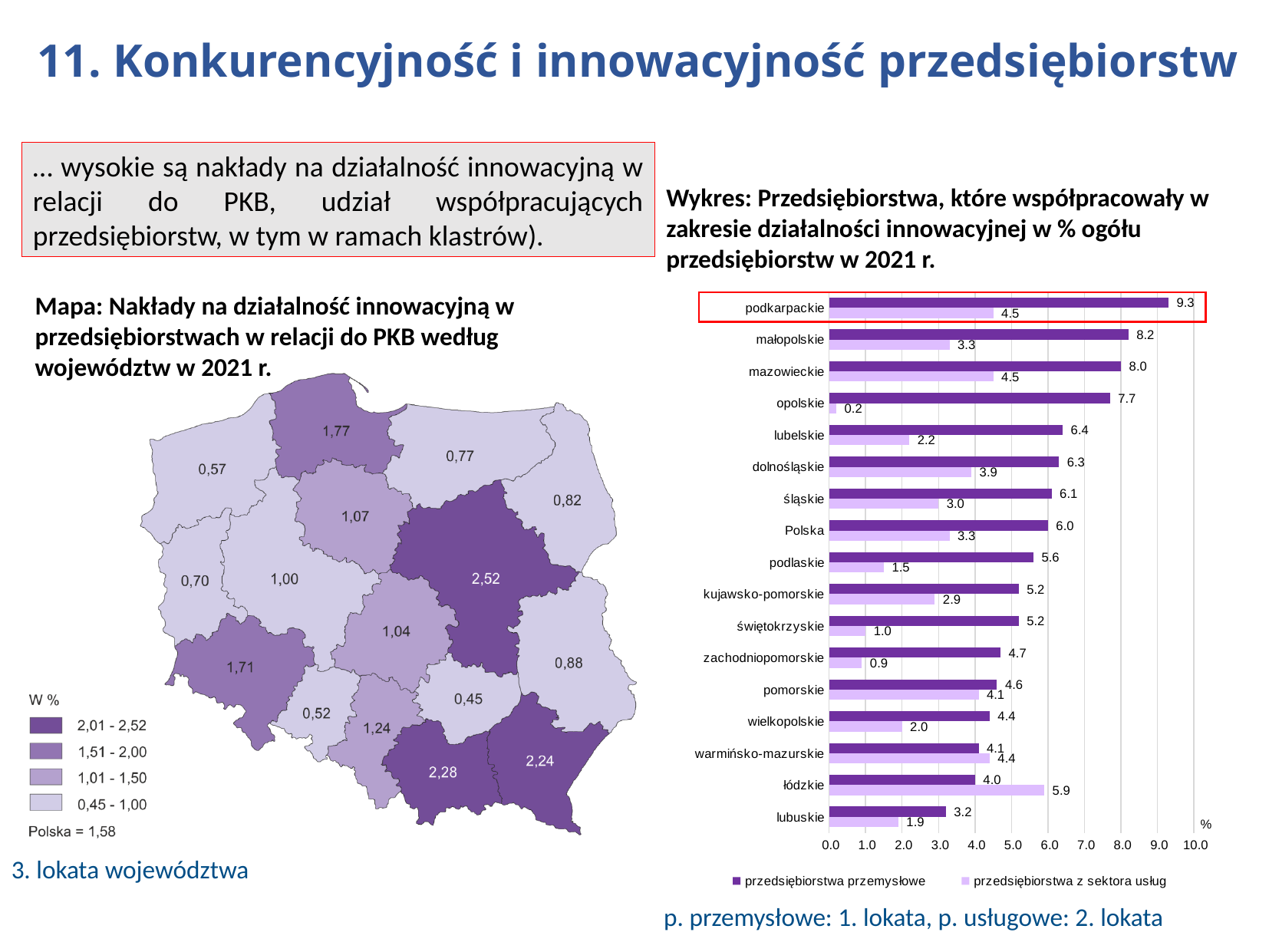
On the bar chart, what is the value for przedsiębiorstwa z sektora usług in opolskie? 0.2 On the bar chart, how many categories are shown on the vertical axis? 17 On the bar chart, how many series does the legend list? 2 What kind of chart is shown on the right side of the slide? bar chart On the bar chart, what is the difference between the przedsiębiorstwa przemysłowe and przedsiębiorstwa z sektora usług values for małopolskie? 4.9 On the bar chart, which category has the highest value for przedsiębiorstwa z sektora usług? łódzkie On the bar chart, what is the value for przedsiębiorstwa przemysłowe for Polska? 6.0 On the bar chart, which category has the highest value for przedsiębiorstwa przemysłowe? podkarpackie On the bar chart, what is the value for przedsiębiorstwa przemysłowe in podkarpackie? 9.3 On the bar chart, which category has the lowest value for przedsiębiorstwa z sektora usług? opolskie On the map, what is the value shown for Polska? 1,58 On the bar chart, which is larger for warmińsko-mazurskie: przedsiębiorstwa przemysłowe or przedsiębiorstwa z sektora usług? przedsiębiorstwa z sektora usług